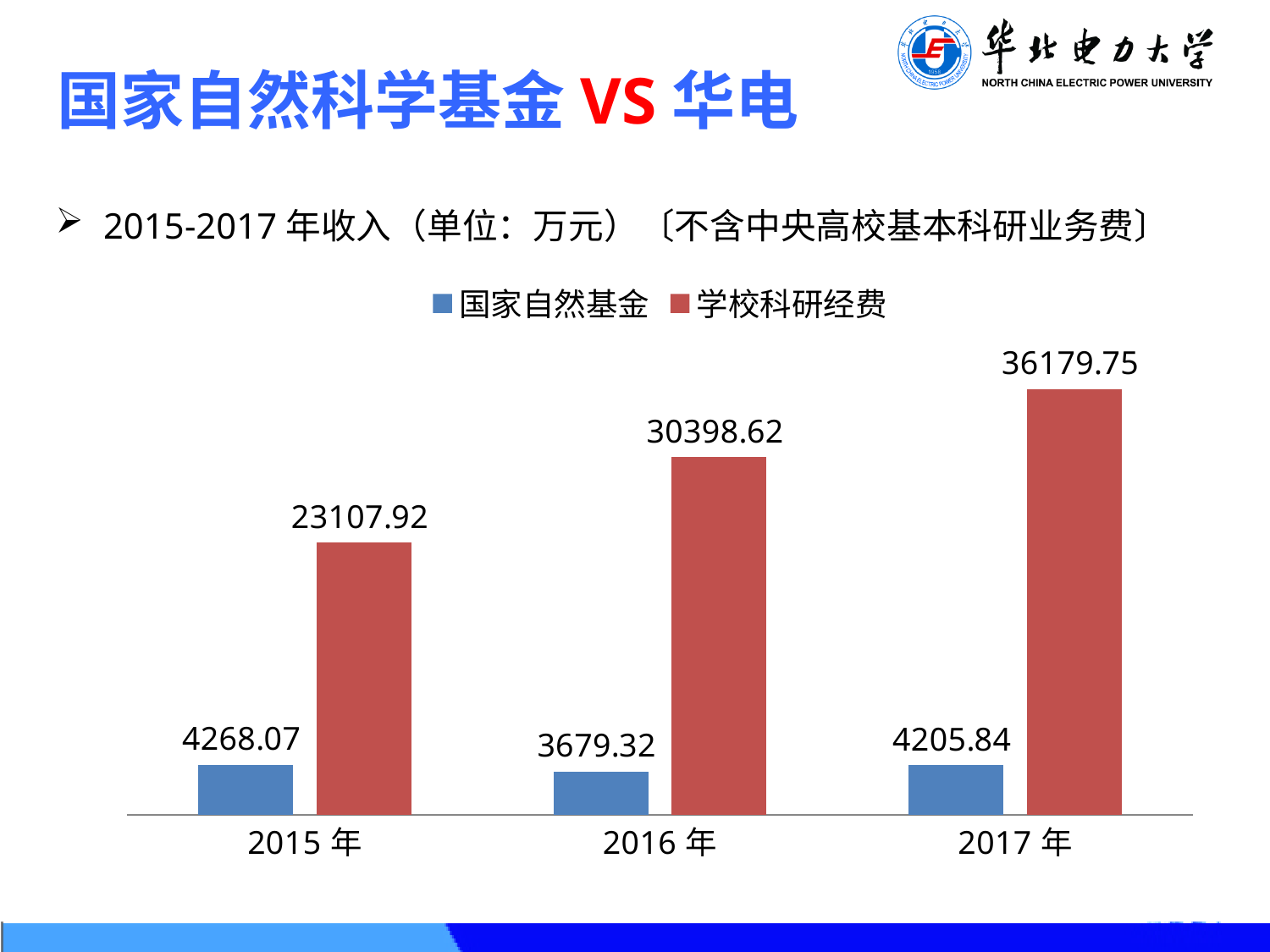
In which year is 学校科研经费 highest? 2017年 What is the difference between 学校科研经费 in 2017年 and 2016年? 5781.13 How many series does the legend list? 2 In which year is 国家自然基金 lowest? 2016年 What is the value of 国家自然基金 for 2015年? 4268.07 What type of chart is shown on the slide? bar chart What is the value of 学校科研经费 for 2017年? 36179.75 How many years are shown on the x axis? 3 What is the difference between 国家自然基金 in 2015年 and 2016年? 588.75 What is the value of 学校科研经费 for 2016年? 30398.62 Does 学校科研经费 rise or fall from 2015年 to 2017年? rise Which is larger: 国家自然基金 in 2015年 or 国家自然基金 in 2017年? 国家自然基金 in 2015年